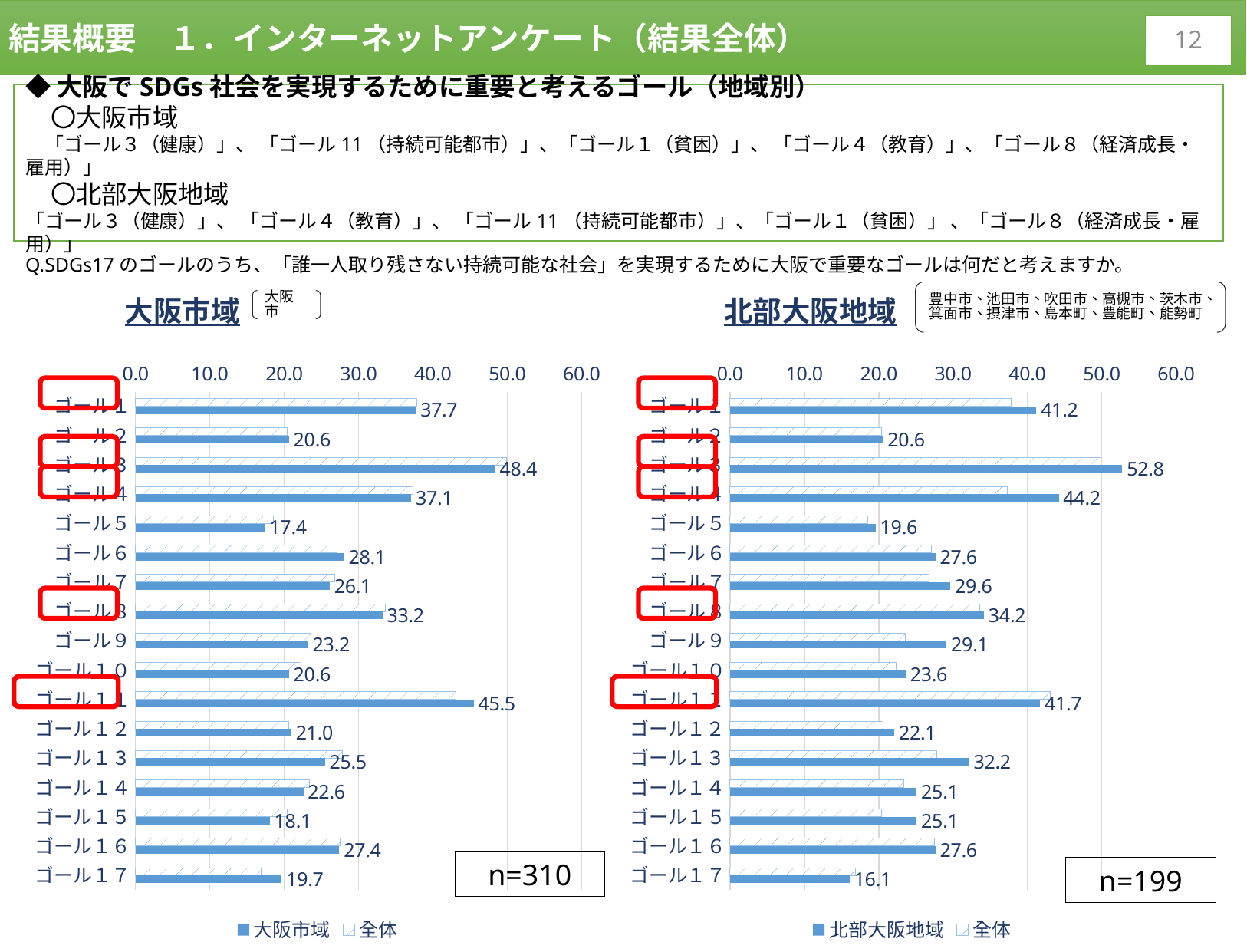
How many goal categories are shown in the 大阪市域 chart? 17 In the 北部大阪地域 chart, what is the difference between the 北部大阪地域 values for ゴール３ and ゴール４? 8.6 In the 大阪市域 chart, which goal has the highest value in the 大阪市域 series? ゴール３ In the 北部大阪地域 chart, which goal has the lowest value in the 北部大阪地域 series? ゴール１７ In the 大阪市域 chart, which is larger in the 大阪市域 series: ゴール１ or ゴール８? ゴール１ In the 北部大阪地域 chart, is the 北部大阪地域 value for ゴール３ greater or less than 50.0? greater How many series does the legend of the 北部大阪地域 chart list? 2 What is the sample size (n) shown for the 北部大阪地域 chart? n=199 In the 北部大阪地域 chart, what is the value for ゴール１１ in the 北部大阪地域 series? 41.7 What type of chart is the 大阪市域 chart? bar chart In the 大阪市域 chart, which goal has the lowest value in the 大阪市域 series? ゴール５ In the 大阪市域 chart, what is the value for ゴール３ in the 大阪市域 series? 48.4